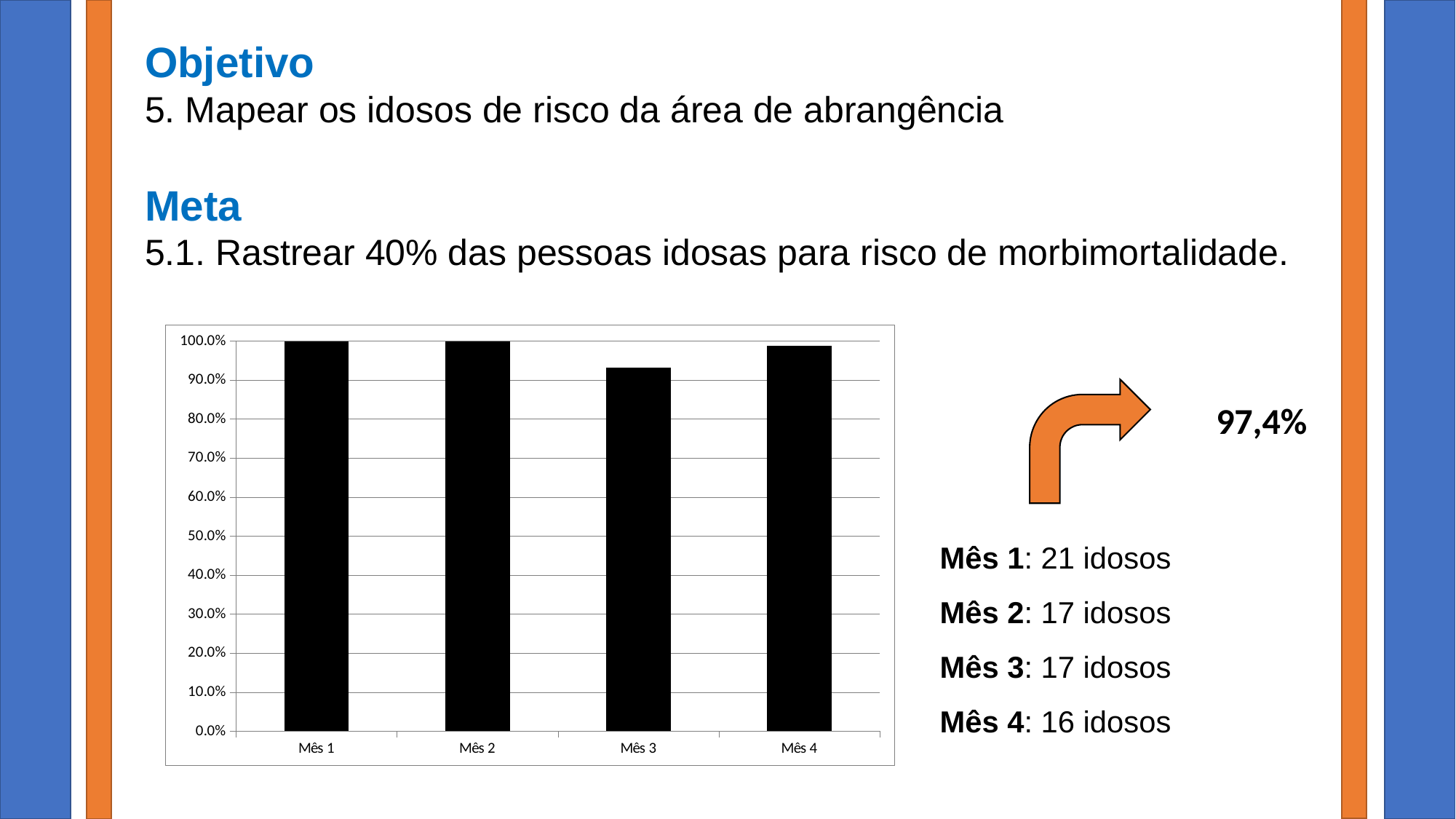
Which is larger in the chart, the value for Mês 2 or the value for Mês 3? Mês 2 Is the value for Mês 4 greater or less than 90.0%? greater What type of chart is shown on the slide? bar chart Is the value for Mês 3 greater or less than 100.0%? less Is the value for Mês 3 greater or less than 90.0%? greater What is the value for Mês 1 in the chart? 100.0% Which is larger in the chart, the value for Mês 4 or the value for Mês 3? Mês 4 What is the highest value shown on the chart's vertical axis? 100.0% Which month has the lowest value in the chart? Mês 3 How many categories (months) are plotted in the chart? 4 What is the value for Mês 2 in the chart? 100.0% What colour are the bars in the chart? black